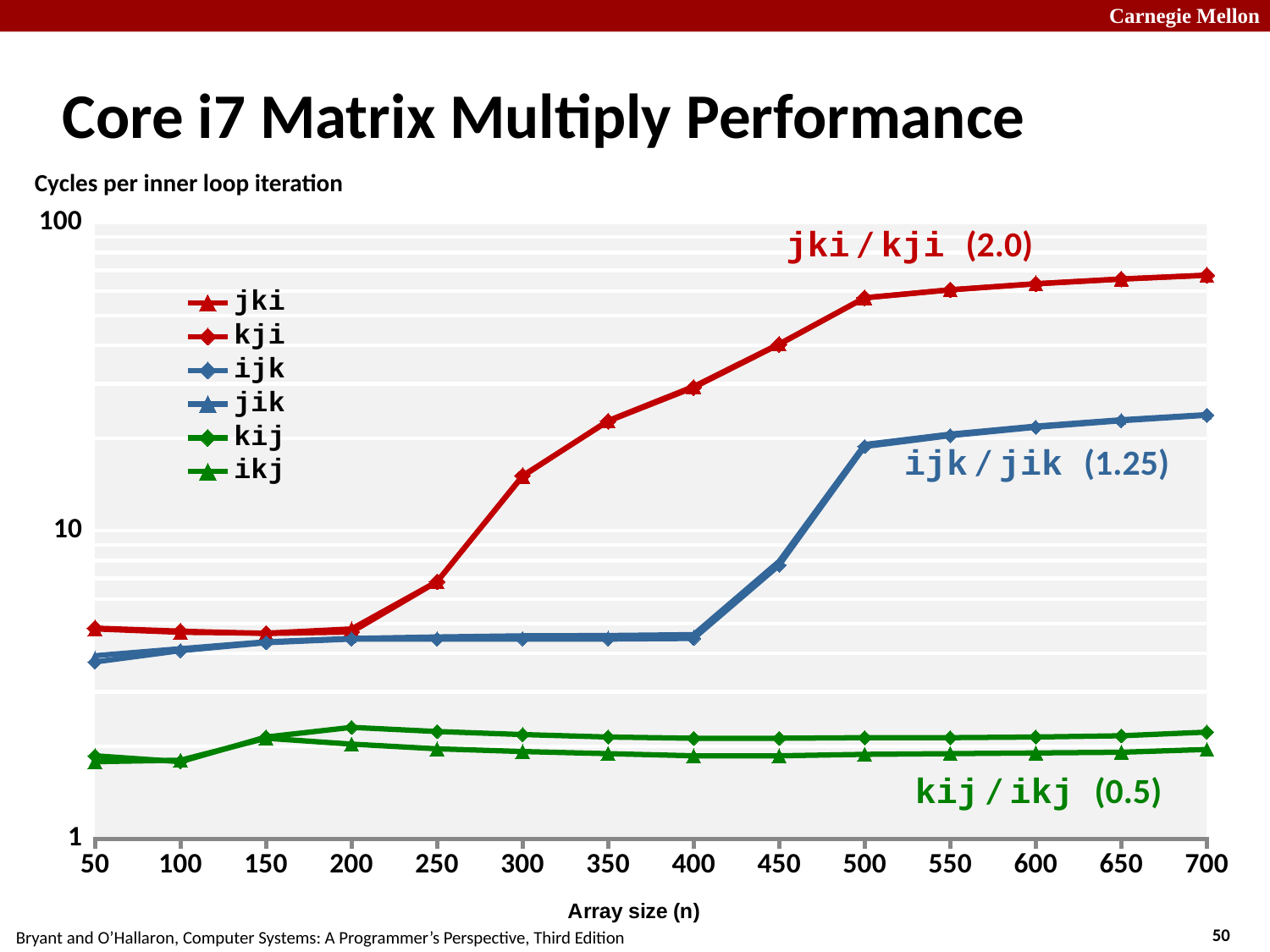
Is the value for ijk at array size 400 greater or less than 10? less What kind of chart is shown on the slide? line chart How many series does the legend list? 6 Is the value for jki at array size 50 greater or less than 10? less At array size 700, which is larger, the value for jki or the value for ijk? jki At array size 700, which is larger, the value for kij or the value for ijk? ijk How many array size values are marked along the x axis? 14 Is the value for jki at array size 700 greater or less than 10? greater Do the values for jki rise or fall as the array size increases from 50 to 700? rise What is the label of the x axis? Array size (n)